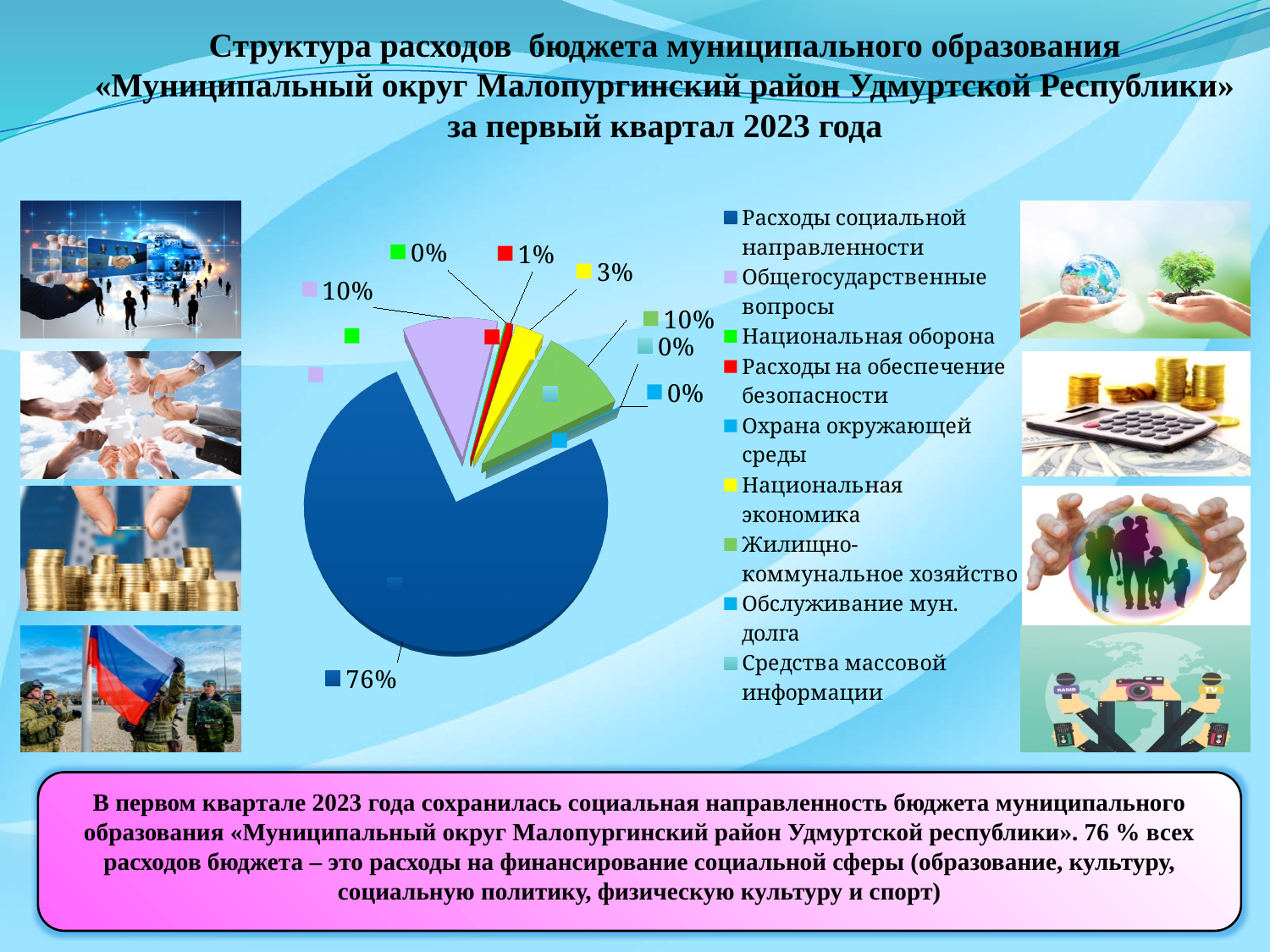
What share is shown for Расходы на обеспечение безопасности? 1% What share of the budget expenditures is labelled for Расходы социальной направленности? 76% By how many percentage points does the share for Расходы социальной направленности exceed the share for Общегосударственные вопросы? 66 percentage points What share is shown for Общегосударственные вопросы? 10% Which is larger: the share for Национальная экономика or the share for Расходы на обеспечение безопасности? Национальная экономика Which category has the largest share of the pie? Расходы социальной направленности What colour is the slice for Расходы социальной направленности? dark blue What share is shown for Национальная оборона? 0% What kind of chart is shown on the slide? pie chart How many categories does the legend list? 9 What share is shown for Национальная экономика? 3% What share is shown for Жилищно-коммунальное хозяйство? 10%